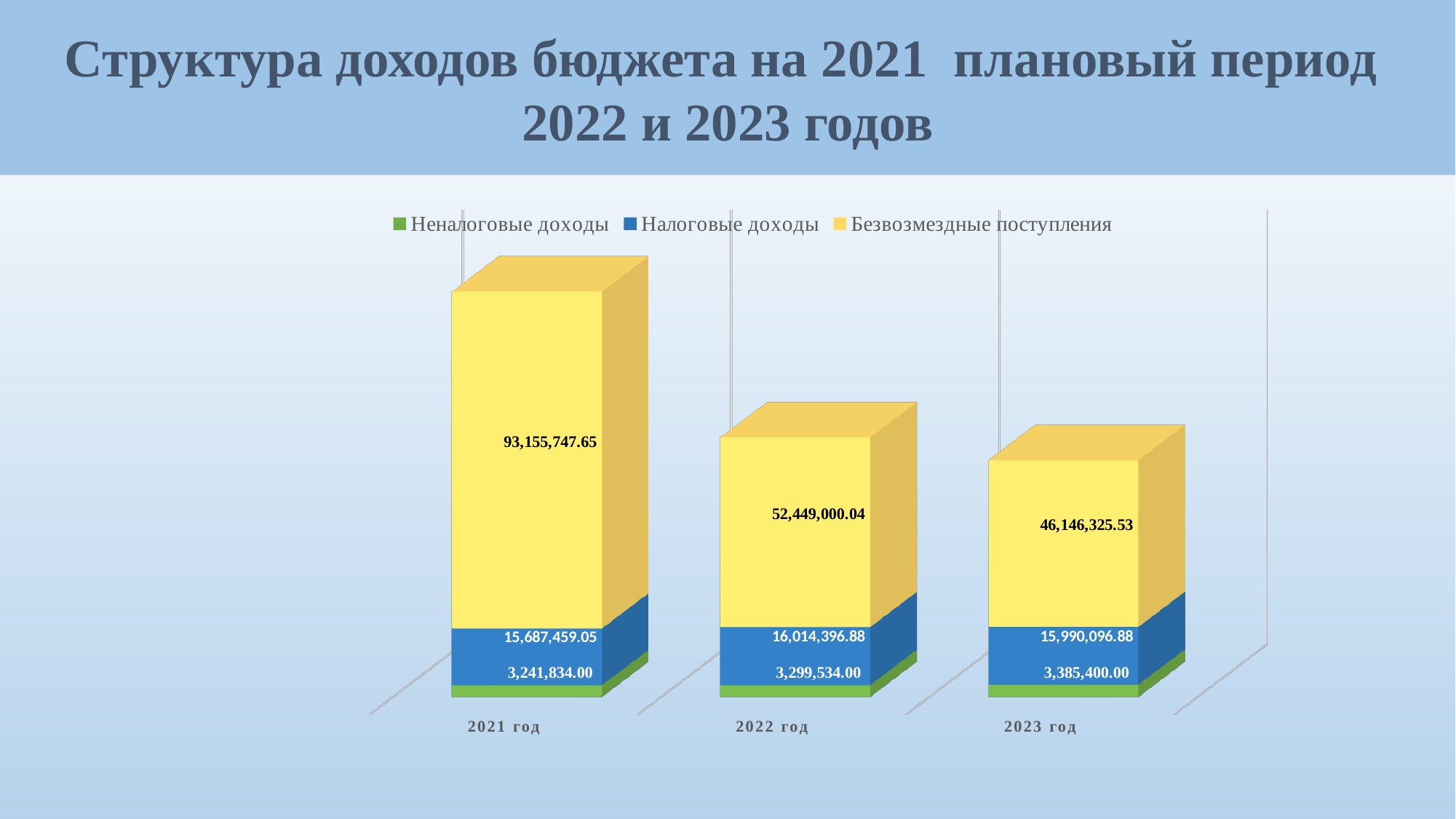
What is the value of Неналоговые доходы for 2023 год? 3,385,400.00 Do the values of Безвозмездные поступления rise or fall from 2021 год to 2023 год? Fall What is the value of Безвозмездные поступления for 2021 год? 93,155,747.65 How many series does the legend list? 3 Which is larger: Налоговые доходы in 2022 год or in 2023 год? 2022 год What is the difference between Безвозмездные поступления in 2021 год and 2022 год? 40,706,747.61 Which year has the lowest value of Неналоговые доходы? 2021 год Which year has the highest value of Безвозмездные поступления? 2021 год What is the value of Налоговые доходы for 2022 год? 16,014,396.88 How many years (categories) are shown on the x axis? 3 What kind of chart is shown on the slide? Stacked bar chart What is the total of the stacked bar for 2022 год? 71,762,930.92